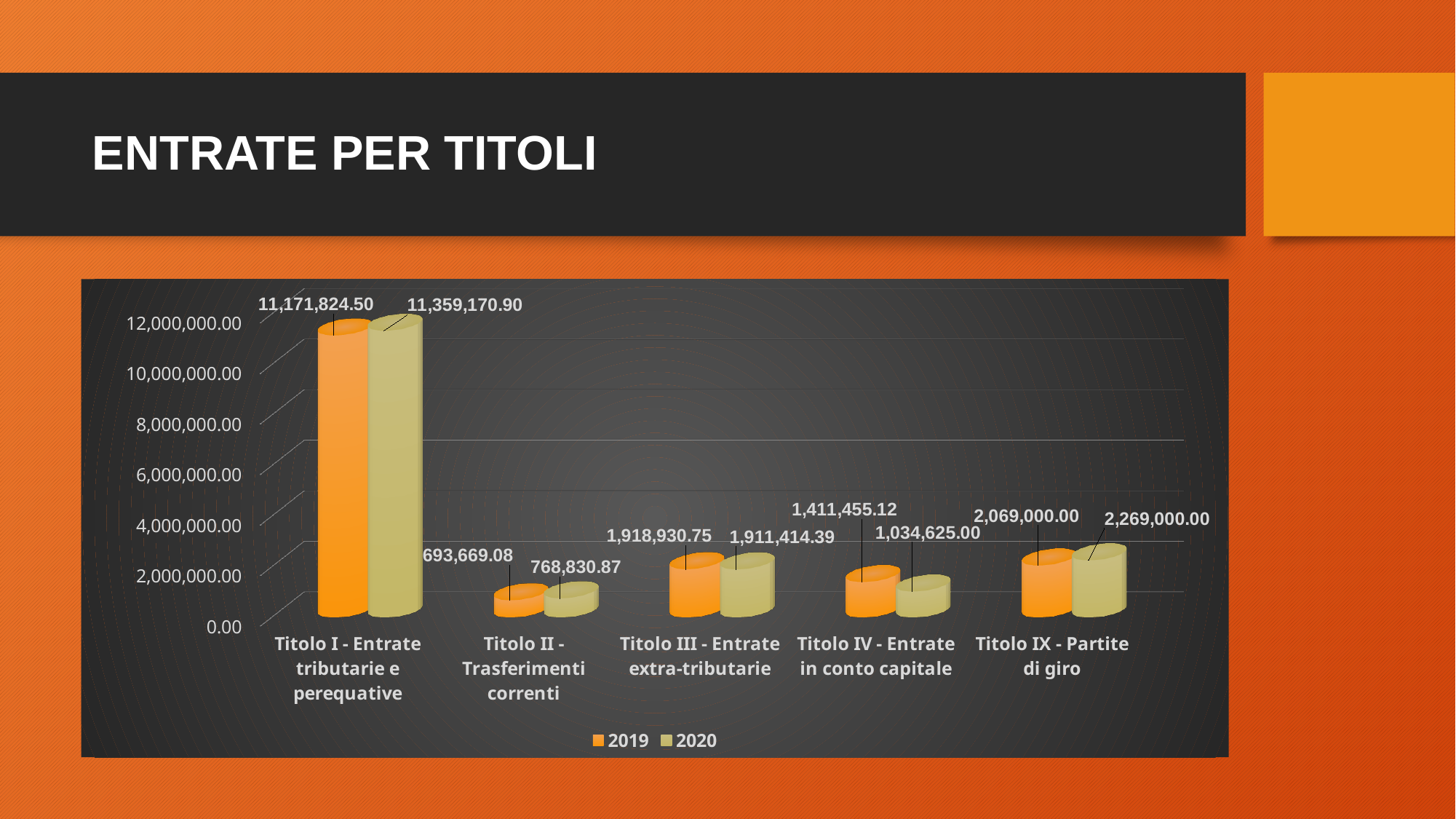
How many categories are shown on the x axis? 5 What is the 2019 value for Titolo I - Entrate tributarie e perequative? 11,171,824.50 What type of chart is shown on the slide? Bar chart Which category has the highest 2020 value? Titolo I - Entrate tributarie e perequative What is the 2020 value for Titolo II - Trasferimenti correnti? 768,830.87 How many series does the legend list? 2 What is the difference between the 2020 and 2019 values for Titolo IX - Partite di giro? 200,000.00 What is the 2020 value for Titolo IV - Entrate in conto capitale? 1,034,625.00 What is the difference between the 2019 and 2020 values for Titolo IV - Entrate in conto capitale? 376,830.12 What is the 2019 value for Titolo IX - Partite di giro? 2,069,000.00 For Titolo IV - Entrate in conto capitale, which year has the larger value, 2019 or 2020? 2019 Which category has the lowest 2019 value? Titolo II - Trasferimenti correnti